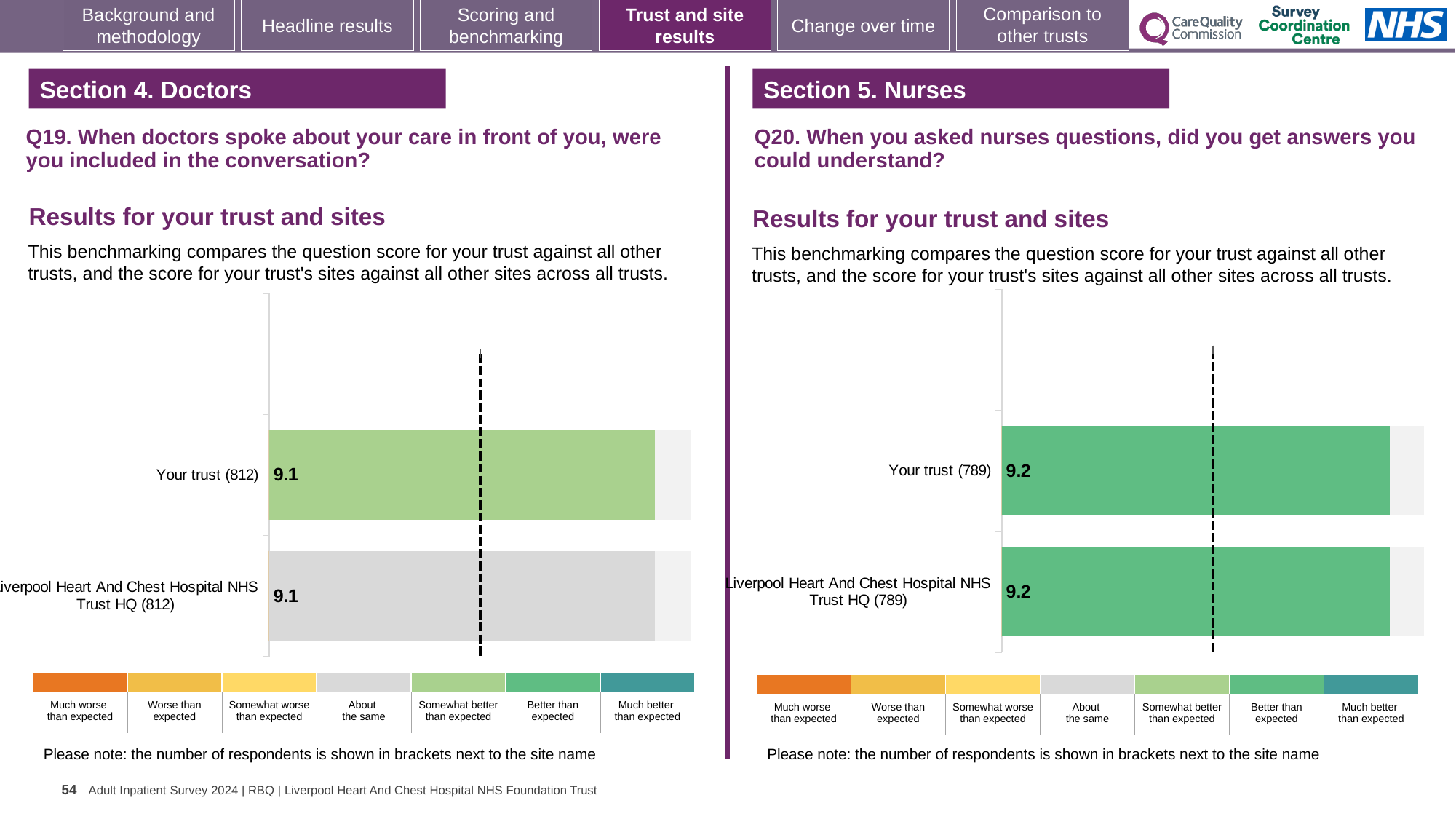
On the Q20 chart (Section 5. Nurses), what is the difference between the score for Your trust and the score for Liverpool Heart And Chest Hospital NHS Trust HQ? 0 Is the score for Your trust on the Q20 chart (Section 5. Nurses) larger than the score for Your trust on the Q19 chart (Section 4. Doctors)? Yes On the Q19 chart (Section 4. Doctors), what is the difference between the score for Your trust and the score for Liverpool Heart And Chest Hospital NHS Trust HQ? 0 On the Q20 chart (Section 5. Nurses), what is the score for Liverpool Heart And Chest Hospital NHS Trust HQ? 9.2 What kind of chart is used for the Q19 results (Section 4. Doctors)? Bar chart How many bars are plotted on the Q19 chart (Section 4. Doctors)? 2 On the Q20 chart (Section 5. Nurses), what is the score for Your trust? 9.2 On the Q19 chart (Section 4. Doctors), what is the score for Liverpool Heart And Chest Hospital NHS Trust HQ? 9.1 On the Q19 chart (Section 4. Doctors), how many respondents are shown in brackets next to Your trust? 812 On the Q19 chart (Section 4. Doctors), what is the score for Your trust? 9.1 How many bars are plotted on the Q20 chart (Section 5. Nurses)? 2 On the Q20 chart (Section 5. Nurses), how many respondents are shown in brackets next to Liverpool Heart And Chest Hospital NHS Trust HQ? 789